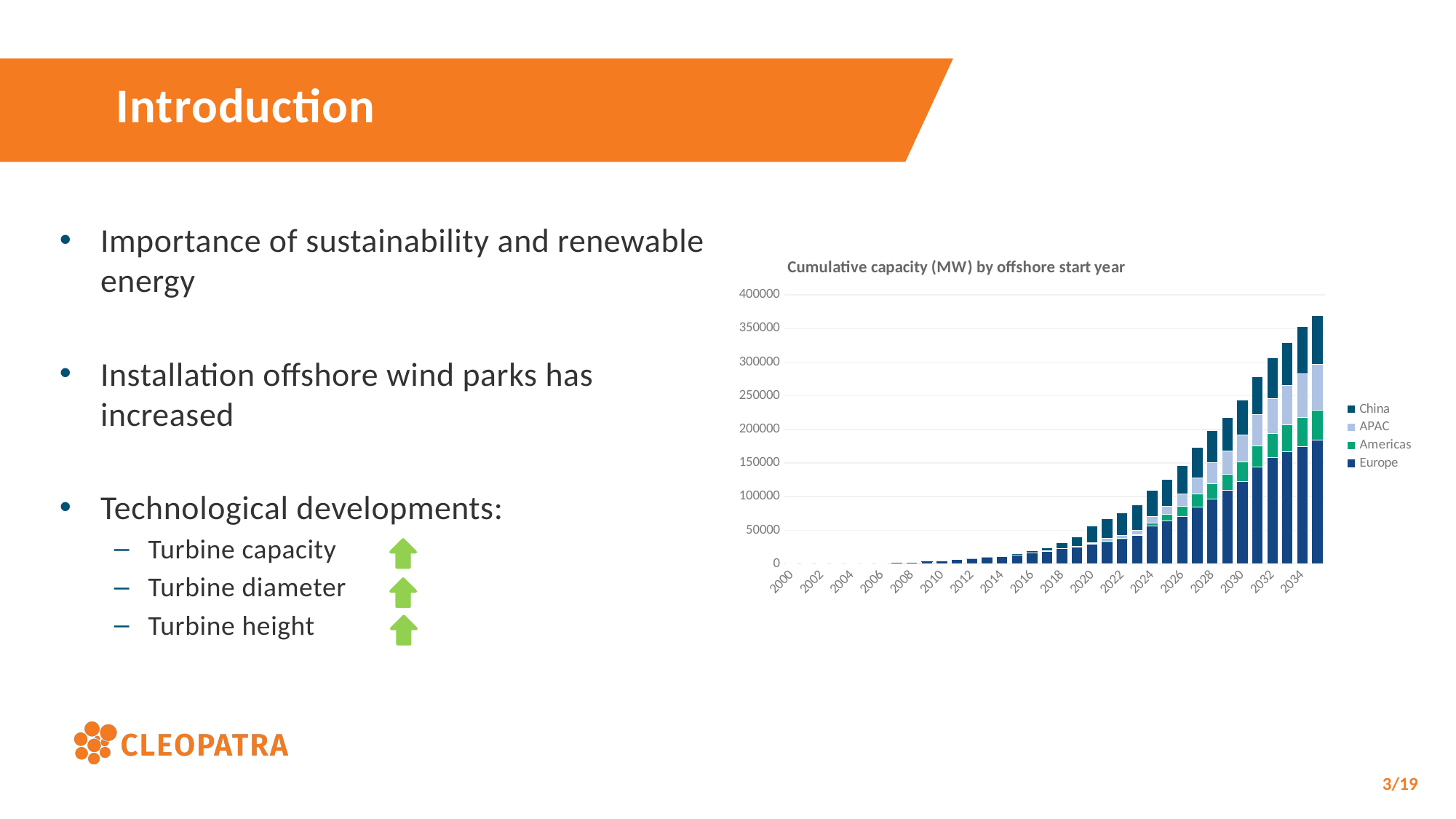
Do the cumulative capacity values rise or fall as the years increase along the x axis? Rise Which year has the larger total cumulative capacity, 2032 or 2024? 2032 Is the total cumulative capacity for 2034 greater or less than 300000? greater Is the total cumulative capacity for 2016 greater or less than 50000? less Is the total cumulative capacity for 2022 greater or less than 100000? less What is the title of the chart? Cumulative capacity (MW) by offshore start year Which regions are listed in the chart's legend? China, APAC, Americas, Europe How many series does the chart's legend list? 4 What kind of chart is shown on the slide? Stacked bar chart Which region contributes the largest share of the 2034 bar? Europe